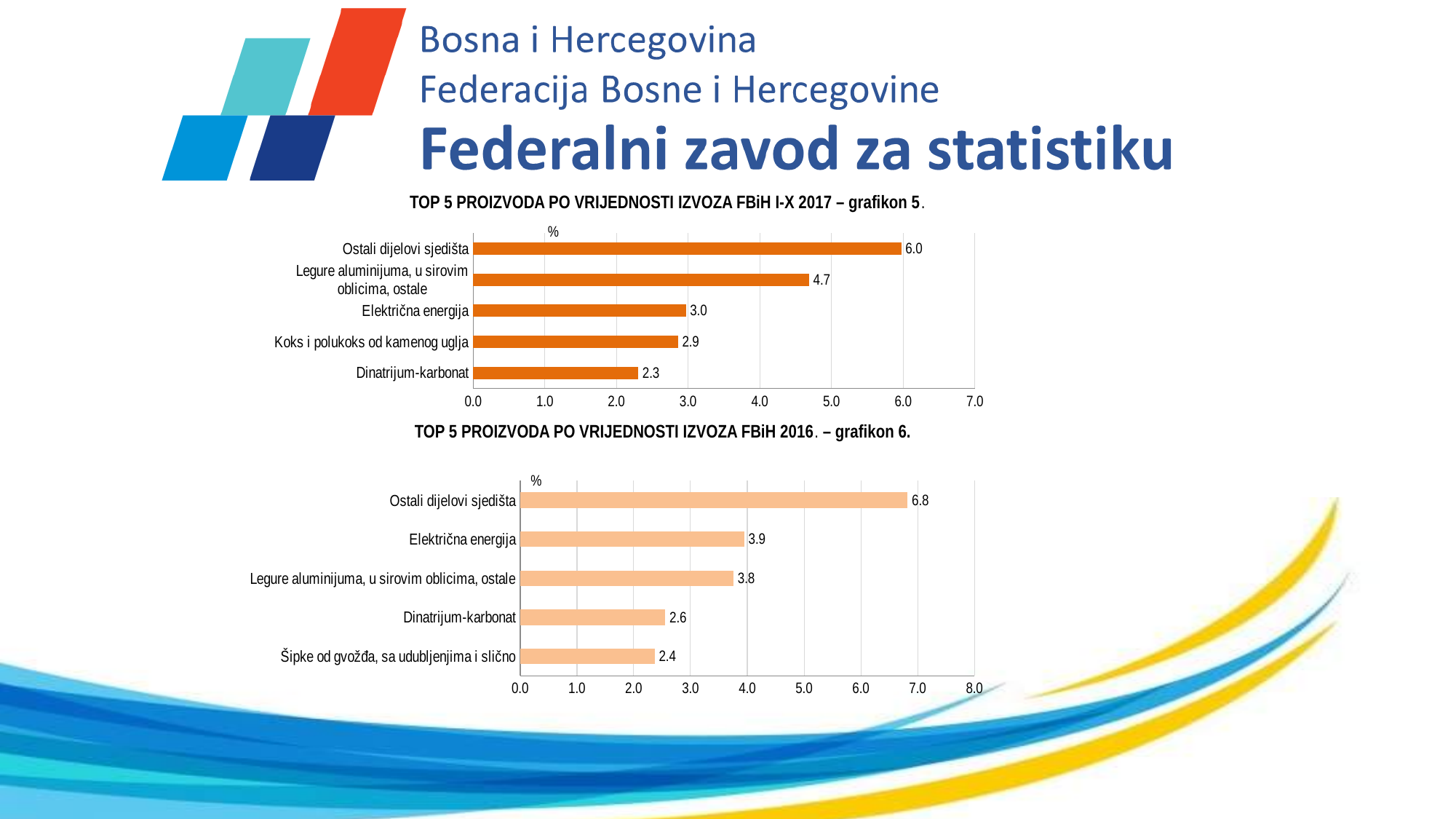
In the bottom chart (grafikon 6, 2016), what is the difference between Ostali dijelovi sjedišta and Dinatrijum-karbonat? 4.2 In the top chart (grafikon 5, I-X 2017), which product has the lowest value? Dinatrijum-karbonat In the top chart (grafikon 5, I-X 2017), what is the difference between Ostali dijelovi sjedišta and Legure aluminijuma, u sirovim oblicima, ostale? 1.3 In the top chart (grafikon 5, I-X 2017), what is the value for Koks i polukoks od kamenog uglja? 2.9 In the bottom chart (grafikon 6, 2016), what is the value for Šipke od gvožđa, sa udubljenjima i slično? 2.4 In the bottom chart (grafikon 6, 2016), which product has the highest value? Ostali dijelovi sjedišta What is the title of the top chart? TOP 5 PROIZVODA PO VRIJEDNOSTI IZVOZA FBiH I-X 2017 – grafikon 5. In the top chart (grafikon 5, I-X 2017), what is the value for Ostali dijelovi sjedišta? 6.0 In the bottom chart (grafikon 6, 2016), what is the value for Električna energija? 3.9 Which is larger: Električna energija in the top chart (2017) or Električna energija in the bottom chart (2016)? Bottom chart (2016), 3.9 What type of chart is the bottom chart (grafikon 6)? Bar chart In the top chart (grafikon 5, I-X 2017), how many products are shown? 5